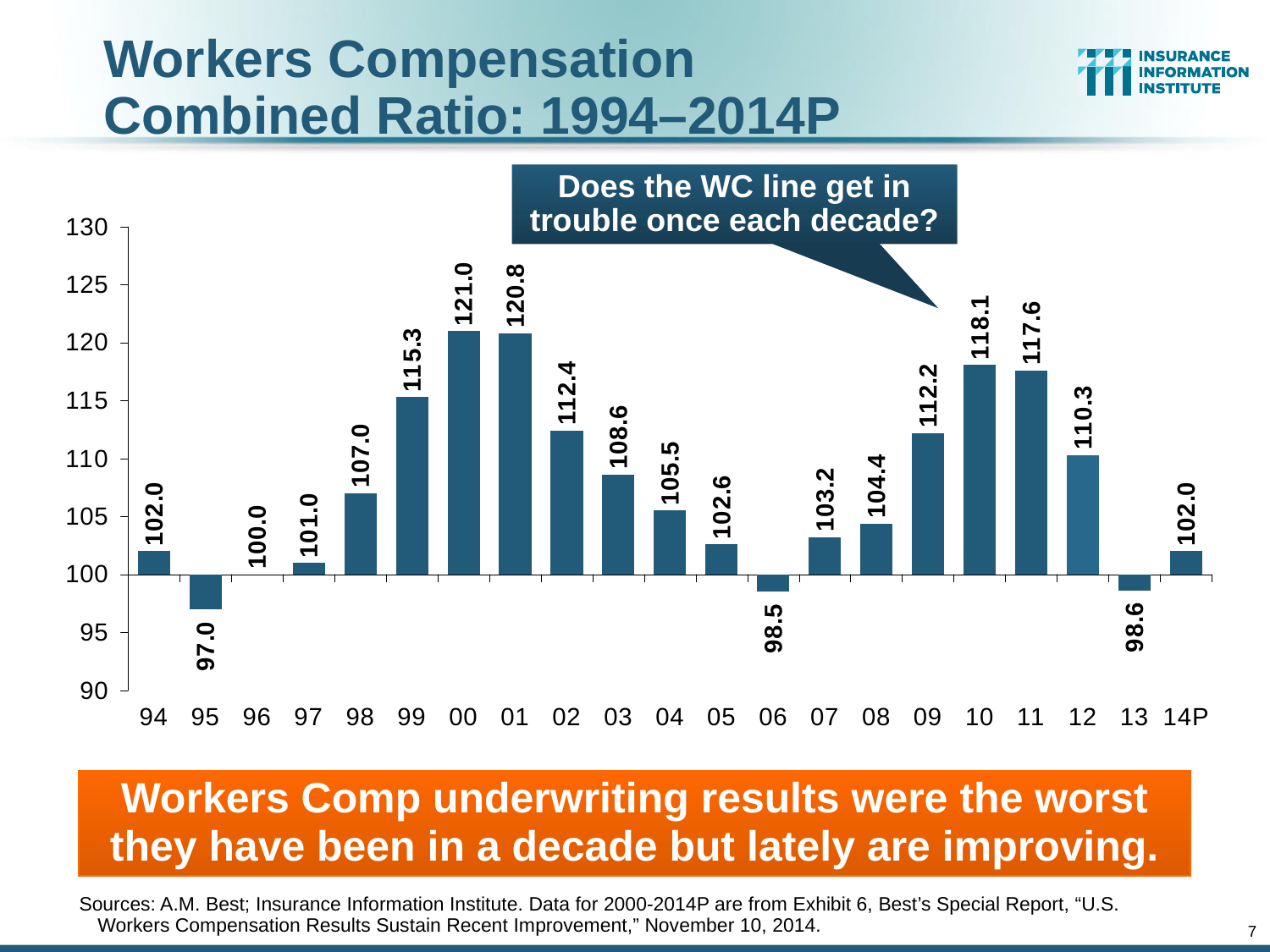
Does the combined ratio rise or fall from 2010 to 2013? fall What is the difference between the combined ratio in 2010 and in 2013? 19.5 What is the workers compensation combined ratio for 2000? 121.0 What is the combined ratio shown for 14P? 102.0 Which year has a higher combined ratio, 2009 or 2012? 2009 What question does the callout box above the chart ask? Does the WC line get in trouble once each decade? Which year has the lowest combined ratio on the chart? 95 Which year has the highest combined ratio on the chart? 00 How many years are plotted on the chart? 21 What kind of chart is shown on the slide? bar chart What is the combined ratio shown for 1995? 97.0 Is the combined ratio for 2006 greater or less than 100? less